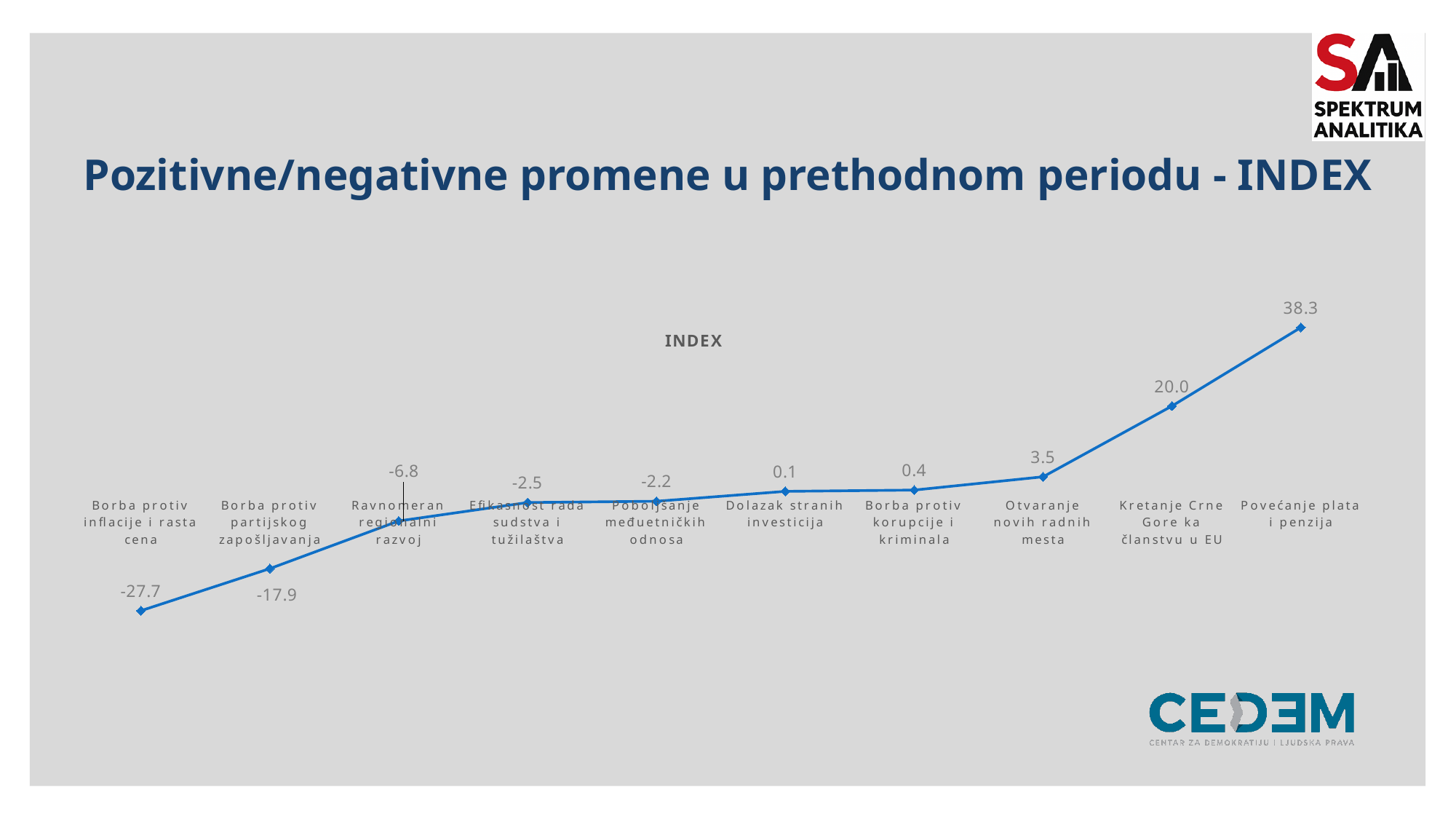
Which category has the highest INDEX value? Povećanje plata i penzija What is the INDEX value for Ravnomeran regionalni razvoj? -6.8 What is the INDEX value for Borba protiv inflacije i rasta cena? -27.7 What kind of chart is shown on the slide? Line chart Which category has the lowest INDEX value? Borba protiv inflacije i rasta cena Which has a higher INDEX value, Borba protiv korupcije i kriminala or Dolazak stranih investicija? Borba protiv korupcije i kriminala What is the INDEX value for Otvaranje novih radnih mesta? 3.5 What is the difference between the INDEX values for Povećanje plata i penzija and Kretanje Crne Gore ka članstvu u EU? 18.3 Do the INDEX values rise or fall from left to right along the x axis? Rise What is the INDEX value for Povećanje plata i penzija? 38.3 What is the INDEX value for Kretanje Crne Gore ka članstvu u EU? 20.0 How many categories are plotted on the chart? 10